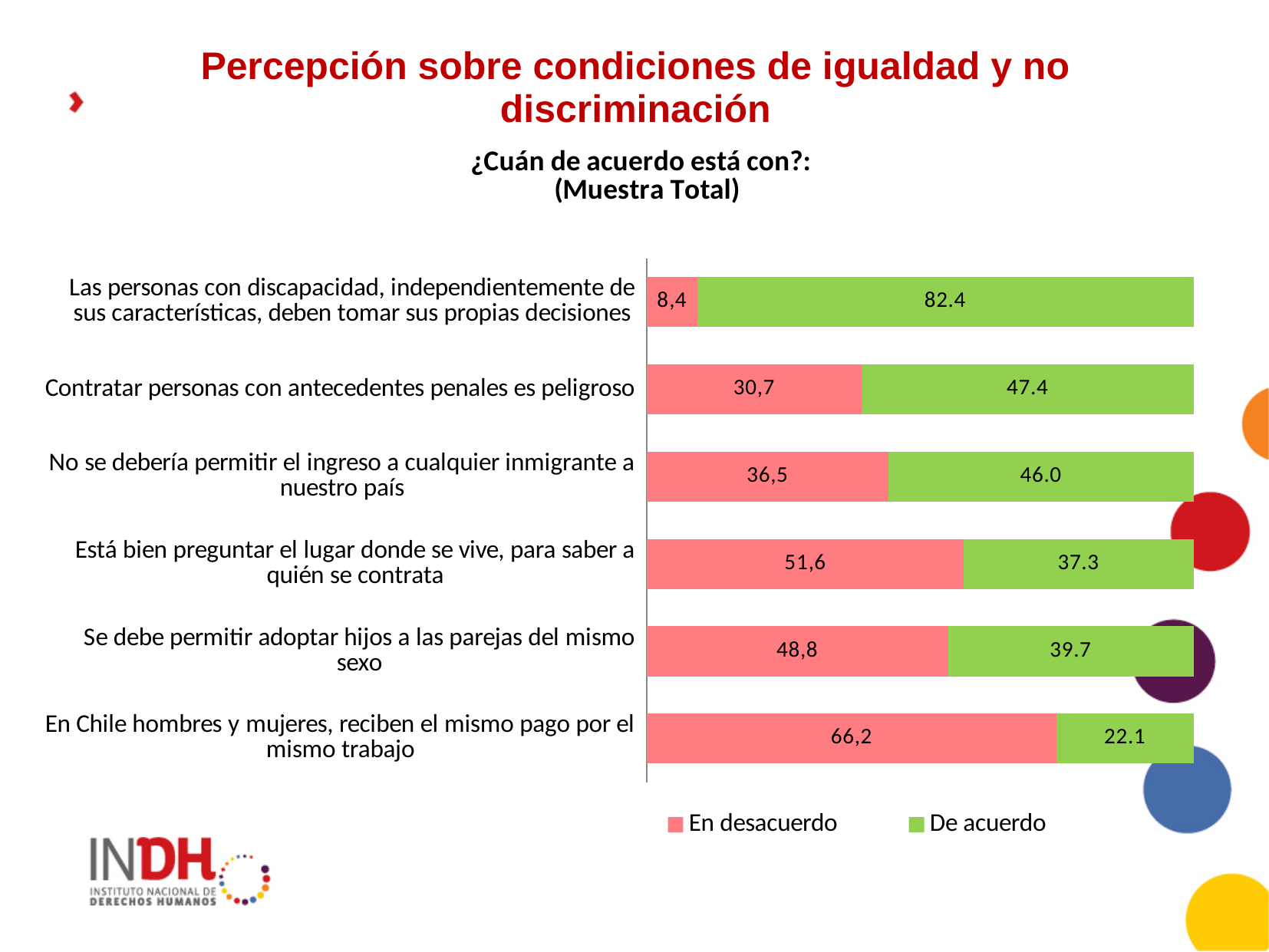
Which statement has the highest 'En desacuerdo' value? En Chile hombres y mujeres, reciben el mismo pago por el mismo trabajo What kind of chart is shown on the slide? Stacked bar chart How many series does the legend list? 2 Which has a larger 'En desacuerdo' value: 'Está bien preguntar el lugar donde se vive, para saber a quién se contrata' or 'Se debe permitir adoptar hijos a las parejas del mismo sexo'? Está bien preguntar el lugar donde se vive, para saber a quién se contrata Which statement has the highest 'De acuerdo' value? Las personas con discapacidad, independientemente de sus características, deben tomar sus propias decisiones How many statements (categories) are shown in the chart? 6 Which statement has the lowest 'En desacuerdo' value? Las personas con discapacidad, independientemente de sus características, deben tomar sus propias decisiones What is the difference between the 'En desacuerdo' values for 'Está bien preguntar el lugar donde se vive, para saber a quién se contrata' and 'Se debe permitir adoptar hijos a las parejas del mismo sexo'? 2,8 What is the 'De acuerdo' value for 'No se debería permitir el ingreso a cualquier inmigrante a nuestro país'? 46.0 What colour represents the 'De acuerdo' series? Green What is the 'De acuerdo' value for 'En Chile hombres y mujeres, reciben el mismo pago por el mismo trabajo'? 22.1 What is the 'En desacuerdo' value for 'Contratar personas con antecedentes penales es peligroso'? 30,7